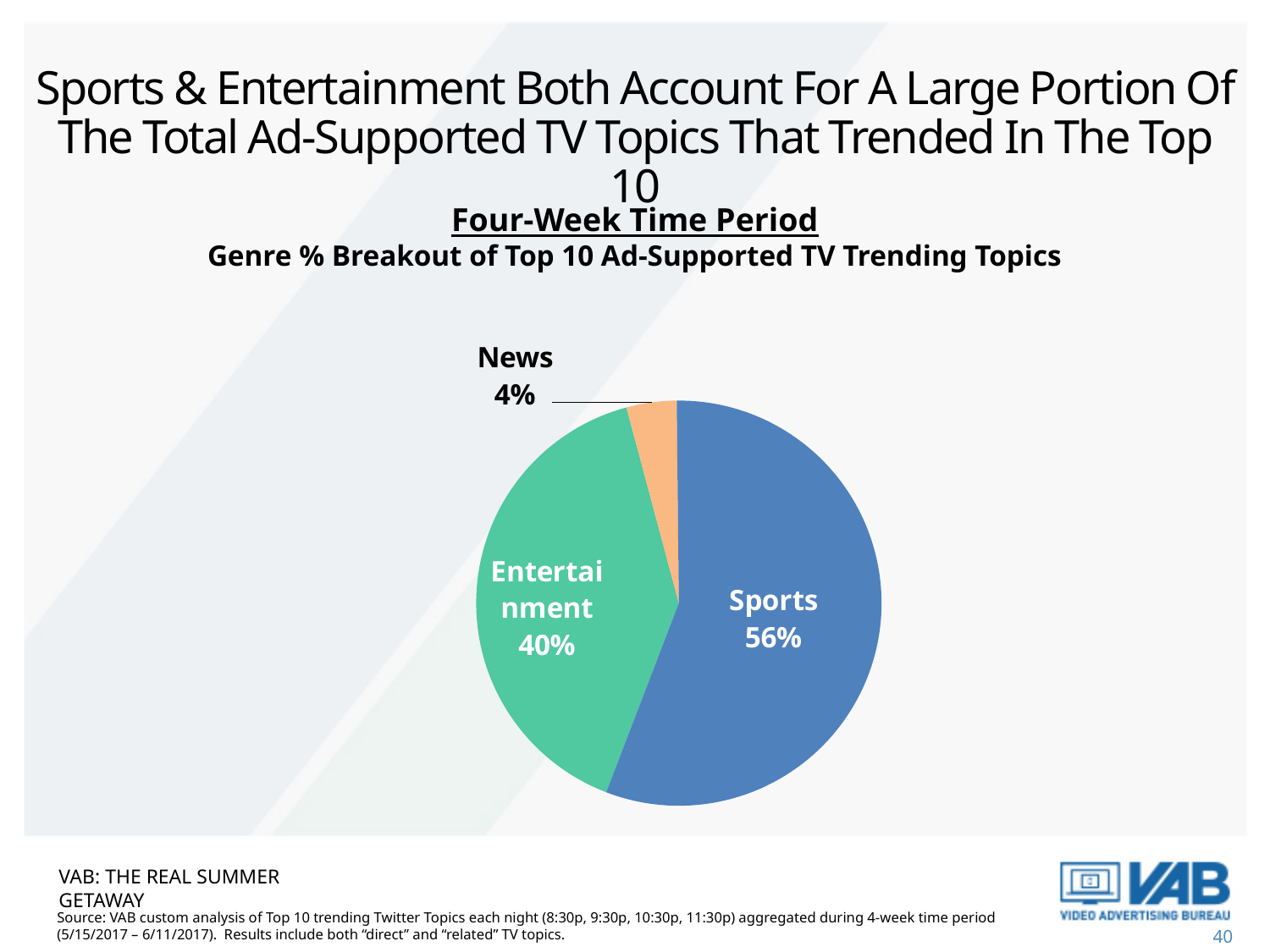
What percentage of the pie does News account for? 4% What kind of chart is shown on the slide? Pie chart What is the difference in percentage points between Entertainment and News? 36 What percentage of the pie does Sports account for? 56% What is the combined share of Sports and Entertainment? 96% What is the difference in percentage points between Sports and Entertainment? 16 What is the subtitle printed directly above the pie chart? Genre % Breakout of Top 10 Ad-Supported TV Trending Topics Which genre has the smallest share of the pie? News Which genre has the largest share of the pie? Sports How many slices does the pie chart have? 3 What percentage of the pie does Entertainment account for? 40% Which is larger, the share for Sports or the share for Entertainment? Sports